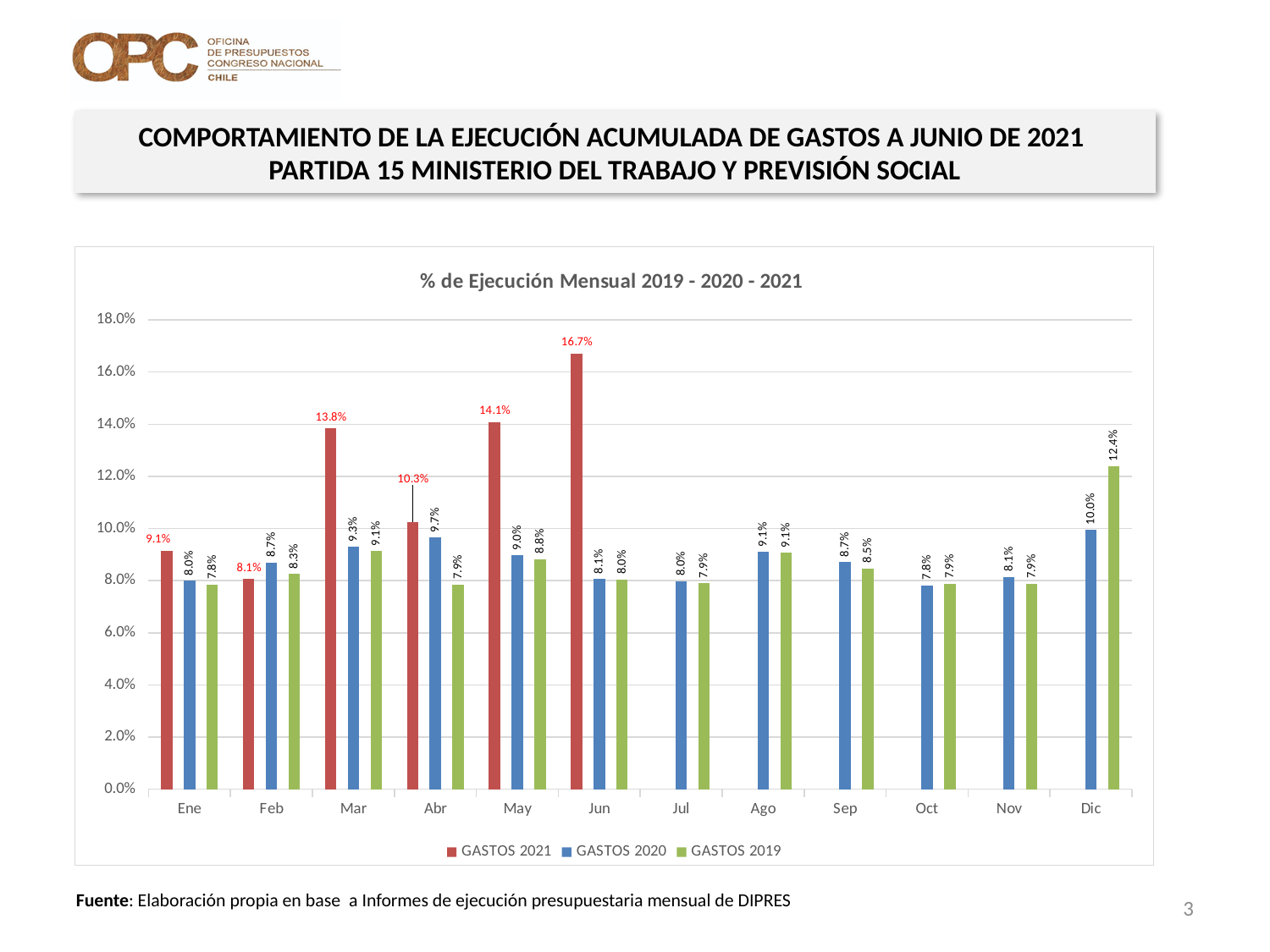
In which month is the GASTOS 2021 value highest? Jun In which month is the GASTOS 2020 value lowest? Oct Is the value for GASTOS 2021 in May greater or less than 12.0%? greater Which is larger in Feb, GASTOS 2021 or GASTOS 2020? GASTOS 2020 What is the title of the chart? % de Ejecución Mensual 2019 - 2020 - 2021 How many series does the legend list? 3 How many months are shown on the x axis? 12 What is the difference between GASTOS 2021 and GASTOS 2020 in Mar? 4.5% What is the value for GASTOS 2021 in Jun? 16.7% What is the value for GASTOS 2020 in Abr? 9.7% What kind of chart is shown? Bar chart What is the value for GASTOS 2019 in Dic? 12.4%